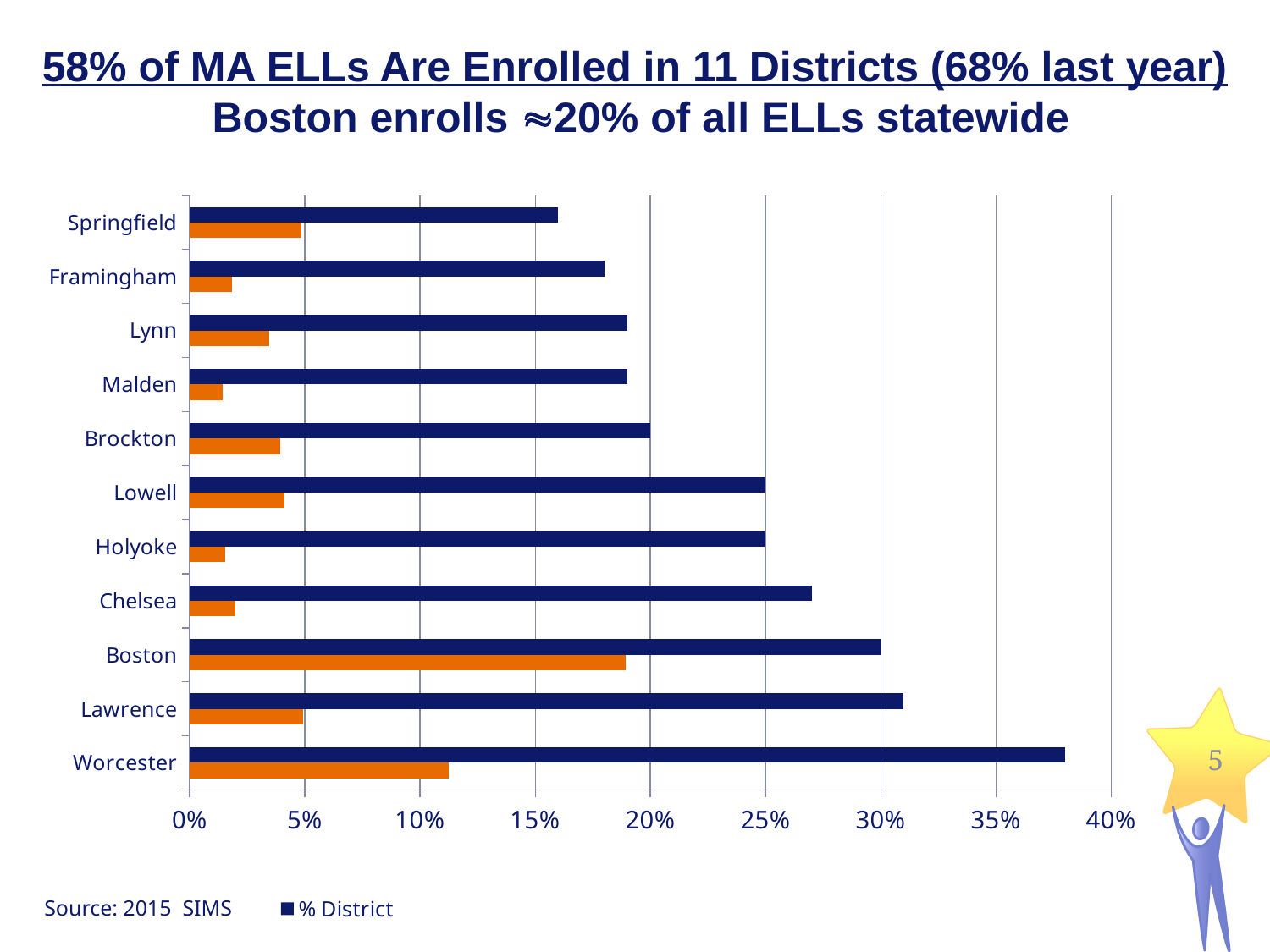
Which district has the longest orange bar? Boston Is the dark blue (% District) value for Springfield greater or less than 20%? less Which district has the larger dark blue (% District) bar, Lawrence or Chelsea? Lawrence Which district has the shortest dark blue (% District) bar? Springfield Which district has the longest dark blue (% District) bar? Worcester Is the orange value for Boston greater or less than 15%? greater What is the name of the series shown in the chart legend? % District How many series does the chart legend list? 1 How many districts are listed on the chart? 11 What kind of chart is shown on the slide? bar chart Is the dark blue (% District) value for Worcester greater or less than 35%? greater Which district has the larger orange bar, Worcester or Lowell? Worcester